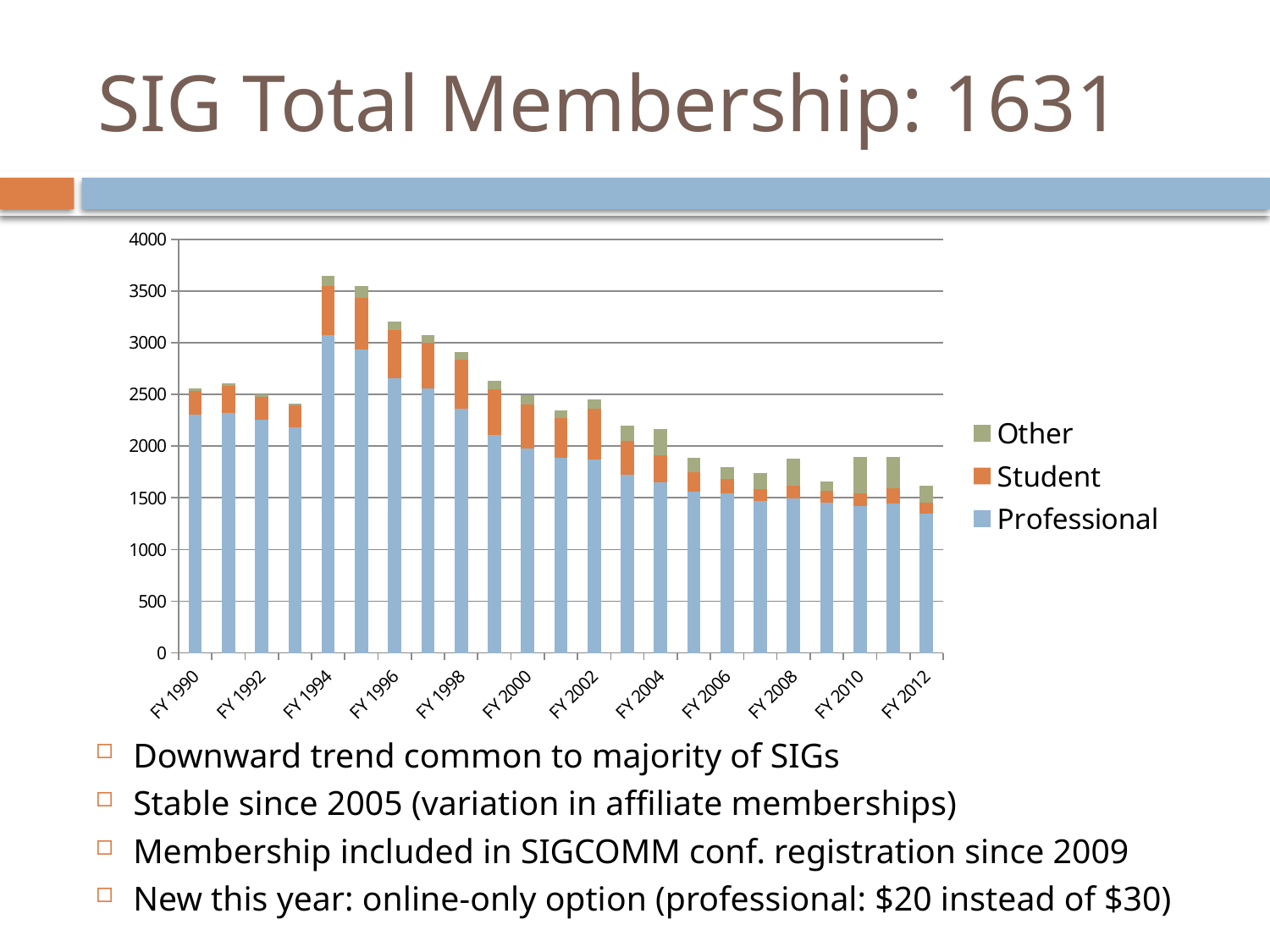
How many series does the chart legend list? 3 Which has a larger total bar, FY 1994 or FY 2000? FY 1994 Is the total bar for FY 1994 greater or less than 3500? greater Is the total bar for FY 2006 greater or less than 2000? less Is the total bar for FY 1990 greater or less than 3000? less What kind of chart is shown on the slide? stacked bar chart Do the total bars generally rise or fall from FY 1994 to FY 2012? fall Which fiscal year has the tallest total bar? FY 1994 Which colour represents the Student series in the chart? orange Which series is shown at the bottom of each stacked bar? Professional